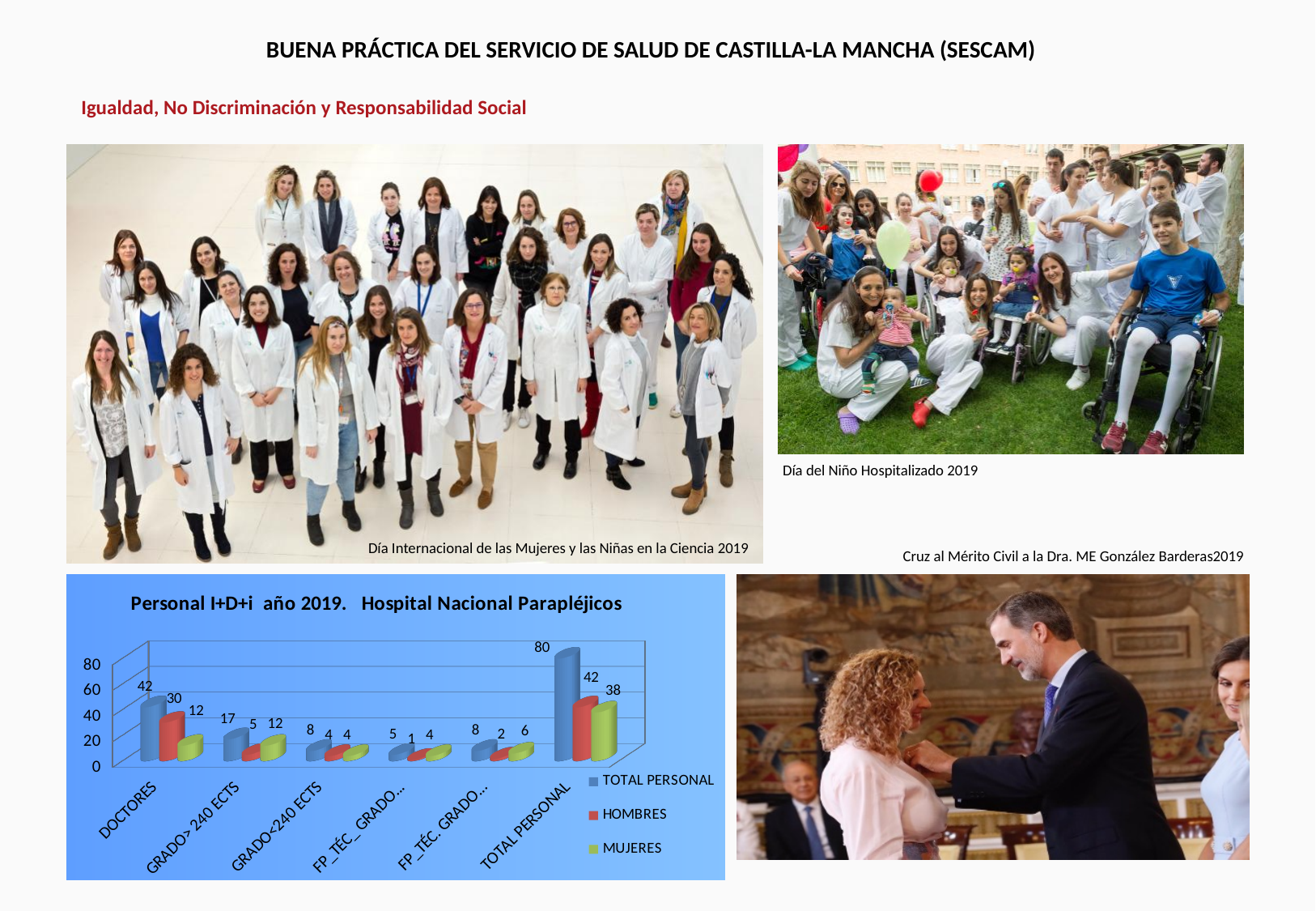
What is the difference between HOMBRES and MUJERES in the TOTAL PERSONAL category? 4 What is the MUJERES value for GRADO> 240 ECTS? 12 What is the HOMBRES value for the TOTAL PERSONAL category? 42 What is the title of the chart? Personal I+D+i año 2019. Hospital Nacional Parapléjicos How many series does the chart legend list? 3 What type of chart is shown on the slide? bar chart How many categories are shown on the x axis of the chart? 6 For GRADO> 240 ECTS, which is larger: HOMBRES or MUJERES? MUJERES Which category has the highest TOTAL PERSONAL value? TOTAL PERSONAL What is the difference between HOMBRES and MUJERES for DOCTORES? 18 What is the HOMBRES value for DOCTORES? 30 What is the TOTAL PERSONAL value for DOCTORES? 42